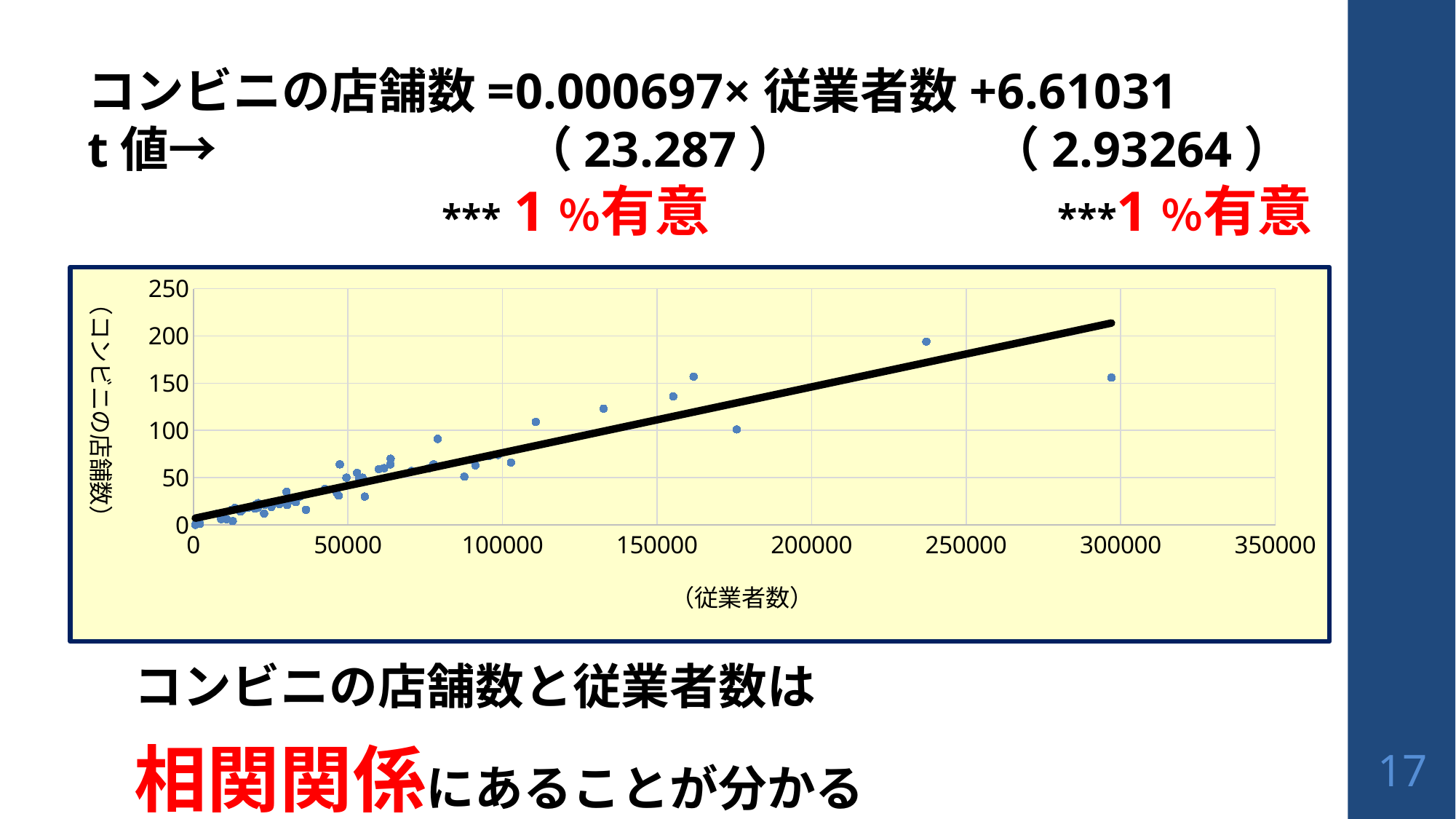
What is the label of the horizontal axis of the chart? （従業者数） Do the plotted values of コンビニの店舗数 rise or fall as 従業者数 increases along the x axis? rise Is the コンビニの店舗数 value of the rightmost plotted point greater or less than 200? less What is the label of the vertical axis of the chart? （コンビニの店舗数） Is the 従業者数 value of the rightmost plotted point greater or less than 250000? greater Is the コンビニの店舗数 value of the highest plotted point greater or less than 150? greater What kind of chart is shown on the slide? scatter chart